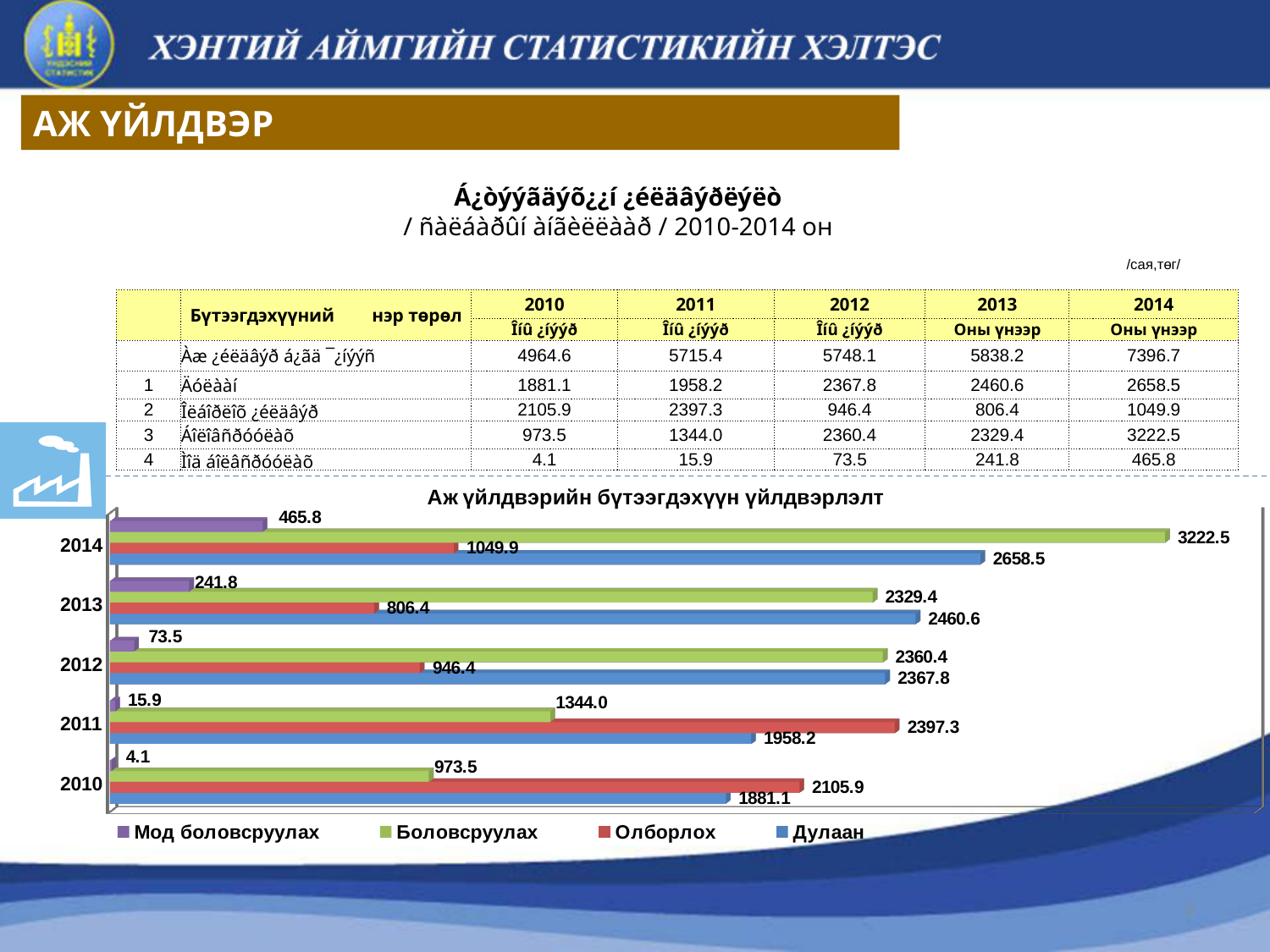
Does the Мод боловсруулах value rise or fall from 2010 to 2014? rise How many years are shown on the chart's category axis? 5 What type of chart is shown on the slide? bar chart What is the value for Мод боловсруулах in 2010? 4.1 Which is larger in 2012, Олборлох or Дулаан? Дулаан What is the value for Боловсруулах in 2014? 3222.5 What is the value for Олборлох in 2011? 2397.3 In which year is the Мод боловсруулах value highest? 2014 What is the difference between the Дулаан values for 2014 and 2013? 197.9 How many series does the chart legend list? 4 What is the value for Дулаан in 2013? 2460.6 In which year is the Боловсруулах value lowest? 2010